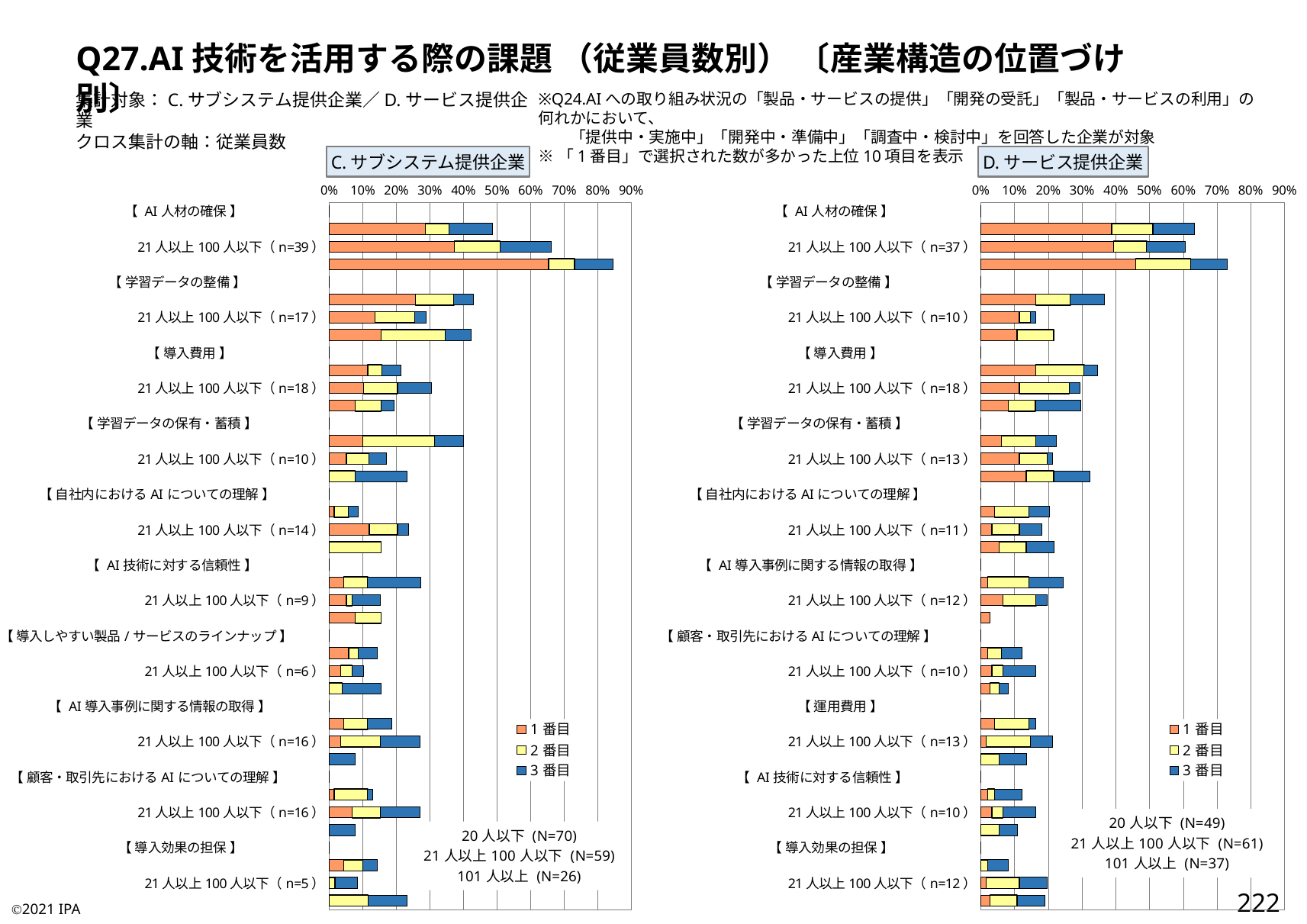
In the left chart (C. サブシステム提供企業), which issue category has the longest total bar for 101人以上? AI人材の確保 In the left chart (C. サブシステム提供企業), under AI人材の確保, which total bar is longer: 20人以下 or 101人以上? 101人以上 In the right chart (D. サービス提供企業), is the total bar for 101人以上 under 学習データの整備 greater or less than 30%? less How many issue categories (bracketed headings) are shown in the right chart (D. サービス提供企業)? 10 In the left chart (C. サブシステム提供企業), is the 1番目 segment for 101人以上 under AI人材の確保 greater or less than 50%? greater What are the legend entries of the left chart (C. サブシステム提供企業)? 1番目, 2番目, 3番目 In the left chart (C. サブシステム提供企業), is the total bar for 101人以上 under AI人材の確保 greater or less than 70%? greater What kind of chart is the left chart titled C. サブシステム提供企業? Stacked bar chart How many series does the legend of the right chart (D. サービス提供企業) list? 3